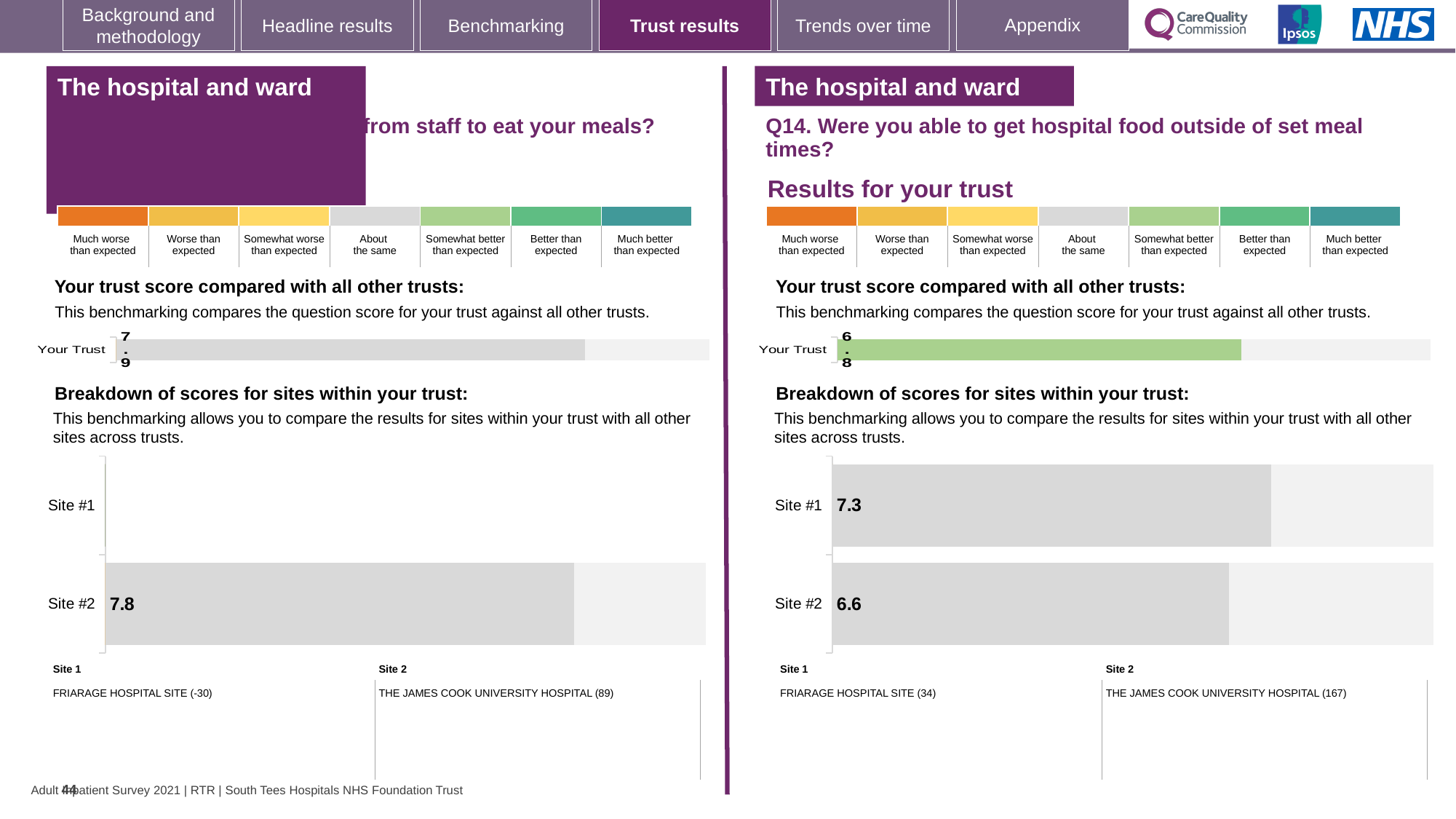
On the left-hand chart, what is the score shown for Your Trust? 7.9 On the left-hand chart, what is the score for Site #2? 7.8 On the left-hand chart, which benchmark category does the colour of the Your Trust bar correspond to? About the same On the right-hand chart (Q14), what is the score shown for Your Trust? 6.8 On the right-hand chart (Q14), how many sites are shown in the breakdown of scores? 2 Which chart shows the higher Site #2 score, the left-hand chart or the right-hand chart (Q14)? The left-hand chart What kind of chart is used to show the breakdown of scores for sites within the trust? Bar chart On the right-hand chart (Q14), what is the score for Site #1? 7.3 On the right-hand chart (Q14), what is the difference between the Site #1 and Site #2 scores? 0.7 On the right-hand chart (Q14), what is the score for Site #2? 6.6 On the right-hand chart (Q14), which benchmark category does the colour of the Your Trust bar correspond to? Somewhat better than expected On the right-hand chart (Q14), which site has the higher score, Site #1 or Site #2? Site #1